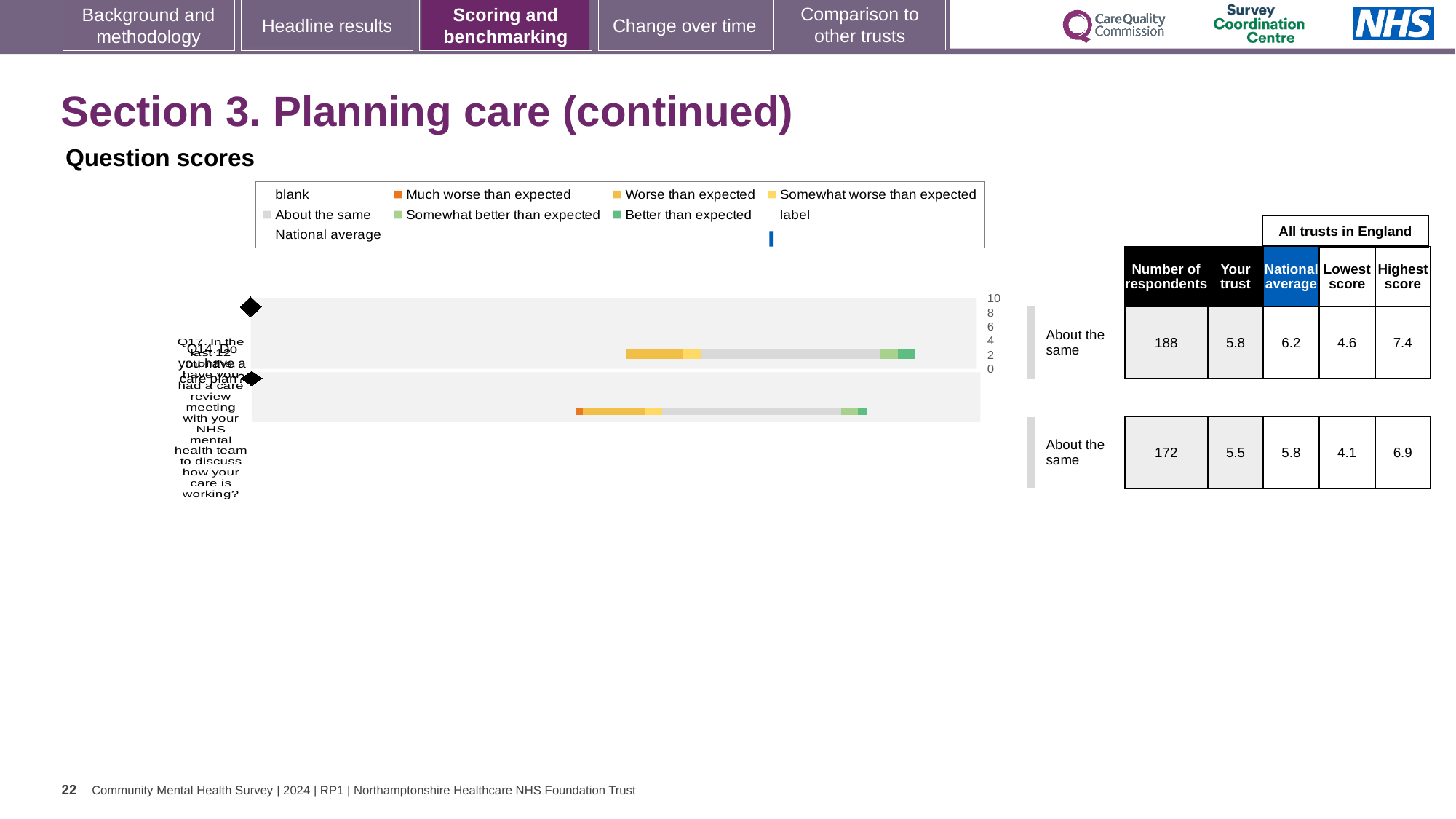
What colour does the legend use for 'National average'? blue What is the difference between the national average and the trust's score for Q14? 0.4 What colour does the legend use for 'Much worse than expected'? orange What is the national average for Q14 in the table beside the chart? 6.2 What is the 'Your trust' score for Q17 in the table beside the chart? 5.5 What benchmark category is shown for Q17 next to the chart? About the same What is the number of respondents for Q14 in the table beside the chart? 188 What is the highest score across all trusts in England for Q17? 6.9 Which question has the higher national average, Q14 or Q17? Q14 How many questions (bars) are plotted in the chart? 2 What is the difference between the highest and lowest score for Q14? 2.8 What kind of chart is shown on the slide? bar chart